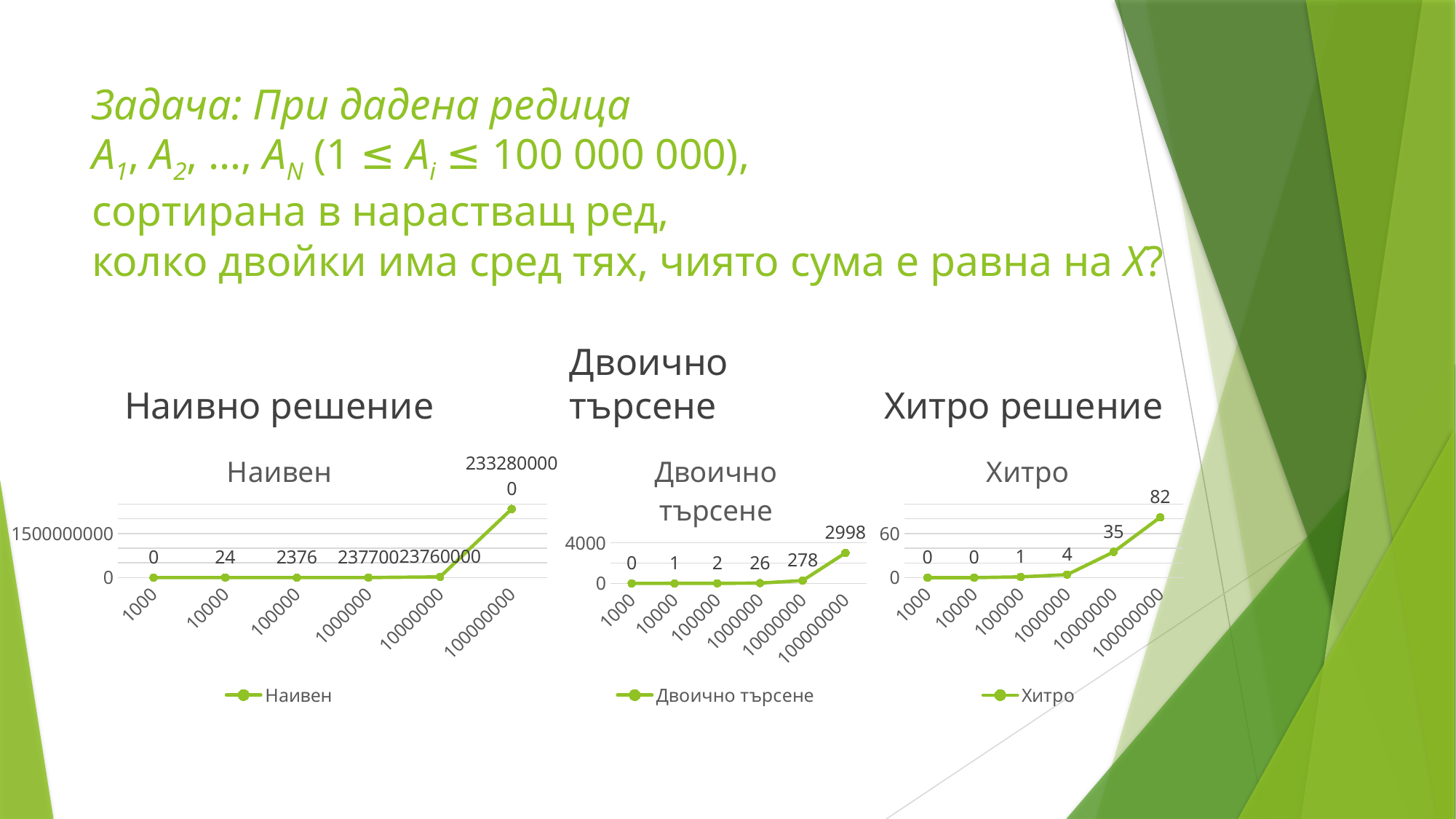
In the chart titled "Двоично търсене", which is larger, the value for 1000000 or the value for 10000000? 10000000 In the chart titled "Хитро", which category has the highest value? 100000000 In the chart titled "Хитро", what is the value for 10000000? 35 How many data points are plotted in the chart titled "Хитро"? 6 In the chart titled "Наивен", what is the value for 100000? 2376 In the chart titled "Двоично търсене", what is the difference between the values for 100000000 and 10000000? 2720 In the chart titled "Хитро", is the value for 100000000 greater or less than 60? greater In the chart titled "Двоично търсене", what is the value for 1000000? 26 What kind of chart is the chart titled "Наивен"? line chart In the chart titled "Двоично търсене", what is the value for 100000000? 2998 In the chart titled "Хитро", what is the difference between the values for 100000000 and 10000000? 47 In the chart titled "Двоично търсене", do the values rise or fall along the x axis? rise